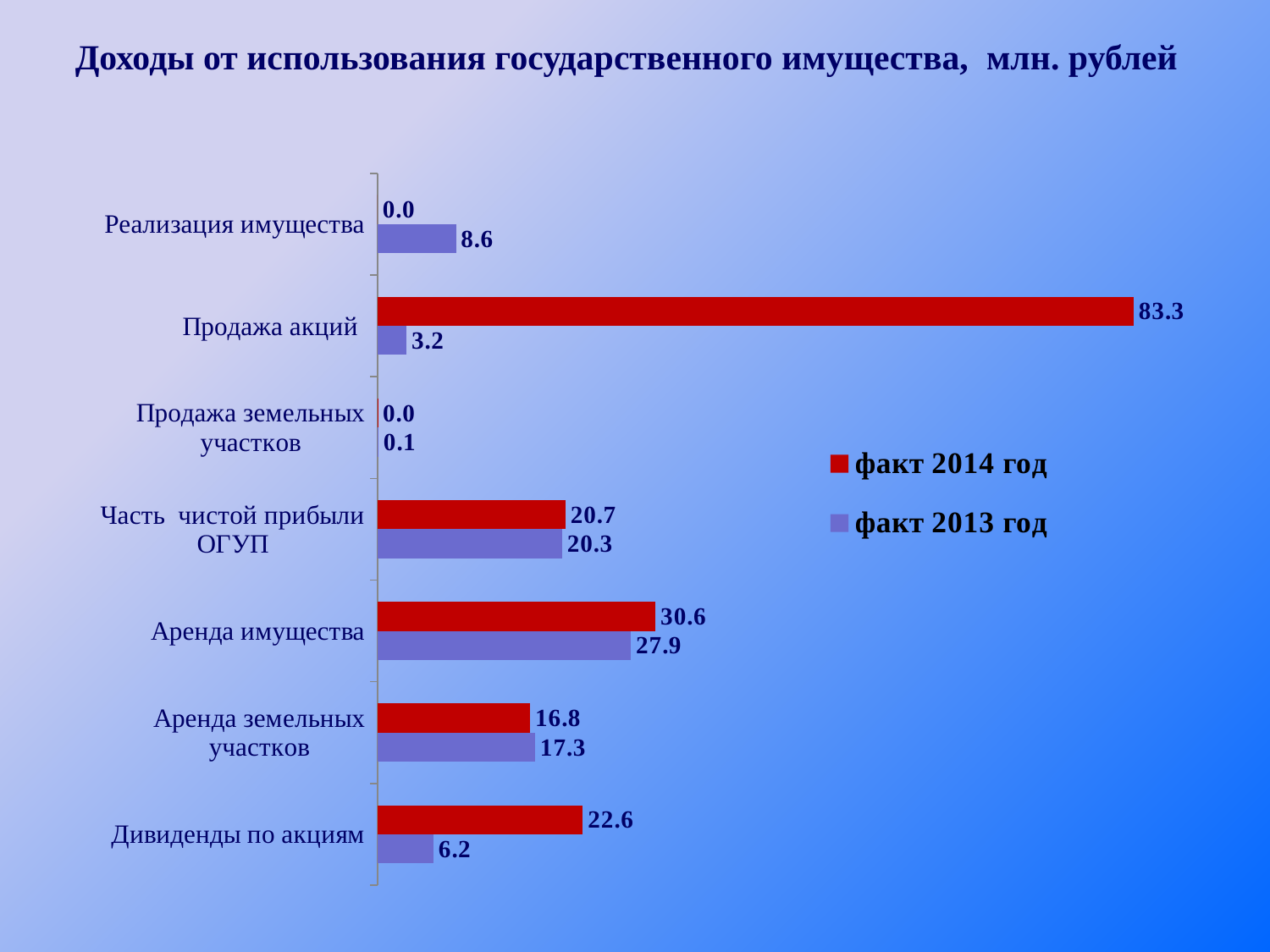
How many series does the legend list? 2 Which category has the lowest value in the факт 2013 год series? Продажа земельных участков What kind of chart is shown on the slide? bar chart What is the title of the chart? Доходы от использования государственного имущества, млн. рублей What is the difference between the факт 2014 год and факт 2013 год values for Дивиденды по акциям? 16.4 Which category has the highest value in the факт 2014 год series? Продажа акций Which is larger for Аренда земельных участков: the факт 2014 год value or the факт 2013 год value? факт 2013 год What is the value for Дивиденды по акциям in the факт 2014 год series? 22.6 What is the value for Реализация имущества in the факт 2013 год series? 8.6 What is the value for Продажа акций in the факт 2014 год series? 83.3 What is the value for Аренда имущества in the факт 2013 год series? 27.9 How many categories are shown on the chart? 7